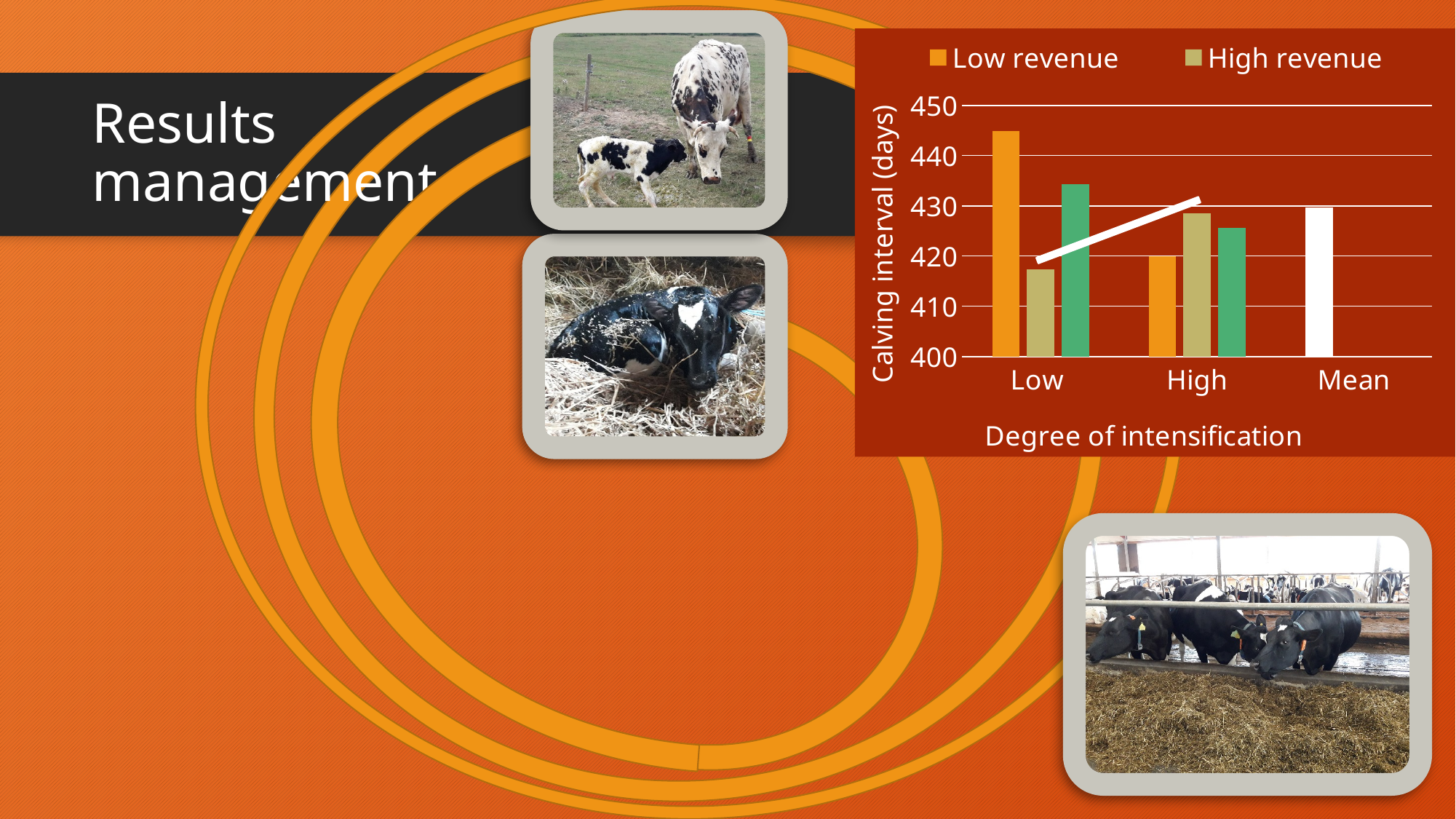
What is the title of the chart's y axis? Calving interval (days) For the Low degree of intensification, which is larger: the Low revenue value or the High revenue value? Low revenue For the High revenue series, which degree of intensification has the lower calving interval, Low or High? Low Is the Low revenue value for the Low degree of intensification greater or less than 440? greater How many categories are shown on the x axis of the chart? 3 What kind of chart is shown on the slide? bar chart Is the High revenue value for the Low degree of intensification greater or less than 420? less What is the title of the chart's x axis? Degree of intensification For the Low revenue series, which degree of intensification has the higher calving interval, Low or High? Low For the High degree of intensification, which is larger: the Low revenue value or the High revenue value? High revenue How many series does the chart's legend list? 2 Is the High revenue value for the High degree of intensification greater or less than 430? less